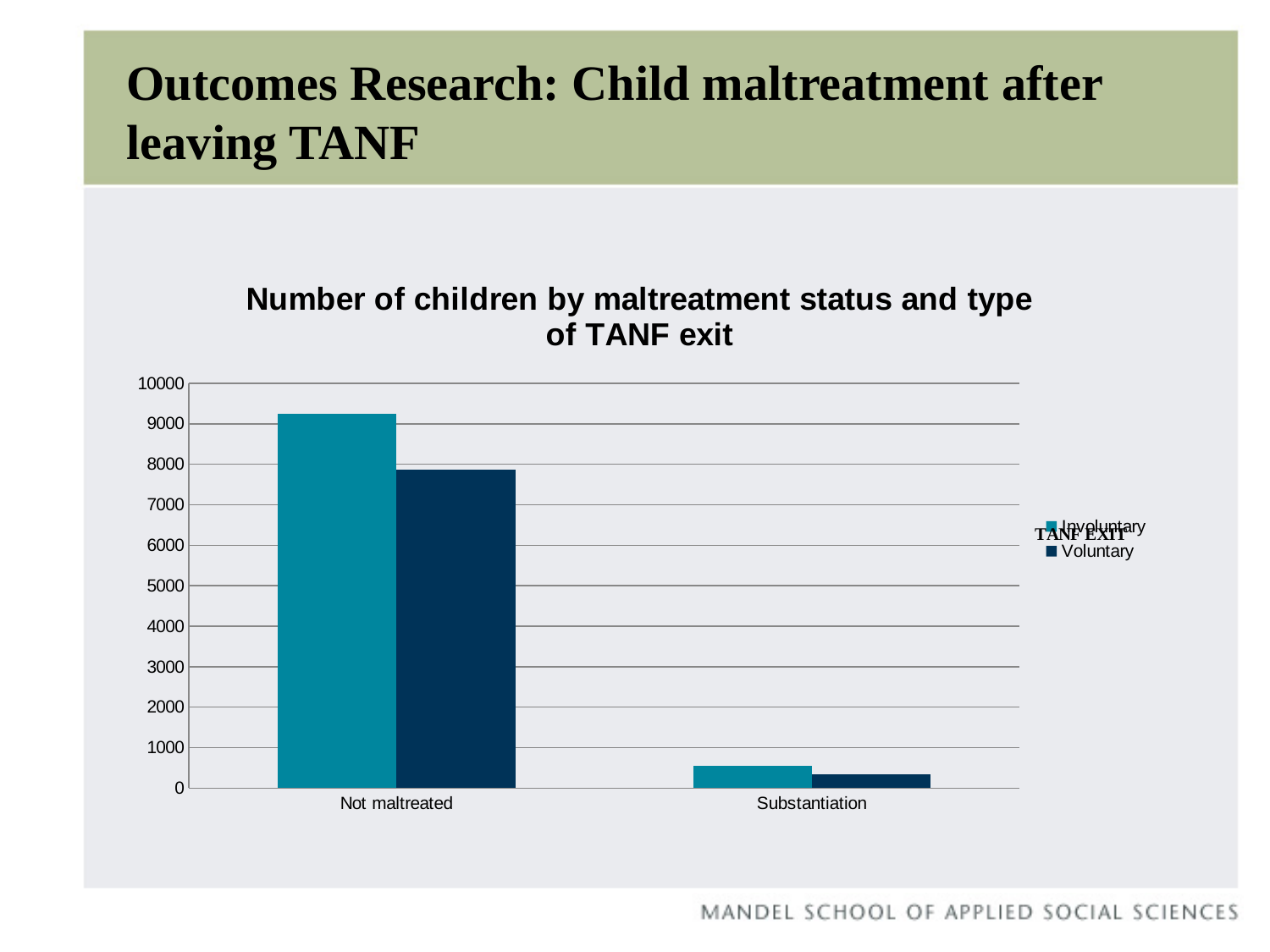
How many series does the legend list? 2 Is the Involuntary value for Not maltreated greater or less than 9000? greater What kind of chart is shown on the slide? bar chart Which category has the highest value for the Involuntary series? Not maltreated For the Not maltreated category, which series has the larger value, Involuntary or Voluntary? Involuntary Is the Voluntary value for Not maltreated greater or less than 8000? less What is the title of the chart? Number of children by maltreatment status and type of TANF exit Is the Involuntary value for Substantiation greater or less than 1000? less Which category has the lowest value for the Voluntary series? Substantiation How many categories are shown on the x axis? 2 Which series is shown in the darker navy colour? Voluntary For the Substantiation category, which series has the larger value, Involuntary or Voluntary? Involuntary